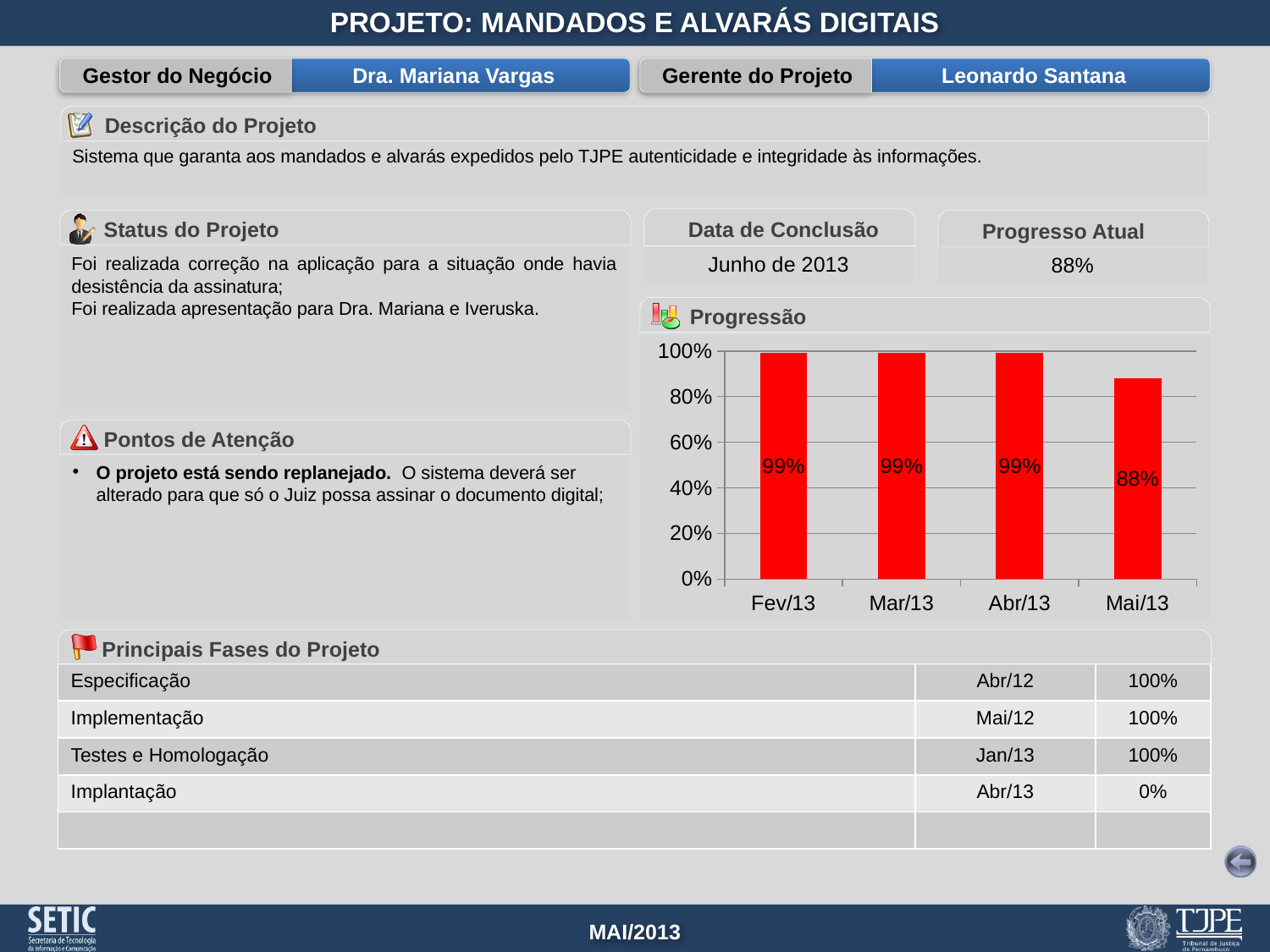
What is the value for Fev/13 in the Progressão chart? 99% How many months are shown on the x axis of the Progressão chart? 4 What kind of chart is the Progressão chart? bar chart What colour are the bars in the Progressão chart? red What is the title of the chart on the slide? Progressão Do the values in the Progressão chart rise or fall from Abr/13 to Mai/13? fall What is the value for Mai/13 in the Progressão chart? 88% What is the difference between the values for Abr/13 and Mai/13 in the Progressão chart? 11% Which is larger in the Progressão chart, the value for Mar/13 or the value for Mai/13? Mar/13 Which month has the lowest value in the Progressão chart? Mai/13 What is the value for Abr/13 in the Progressão chart? 99% Is the value for Mai/13 in the Progressão chart greater or less than 80%? greater